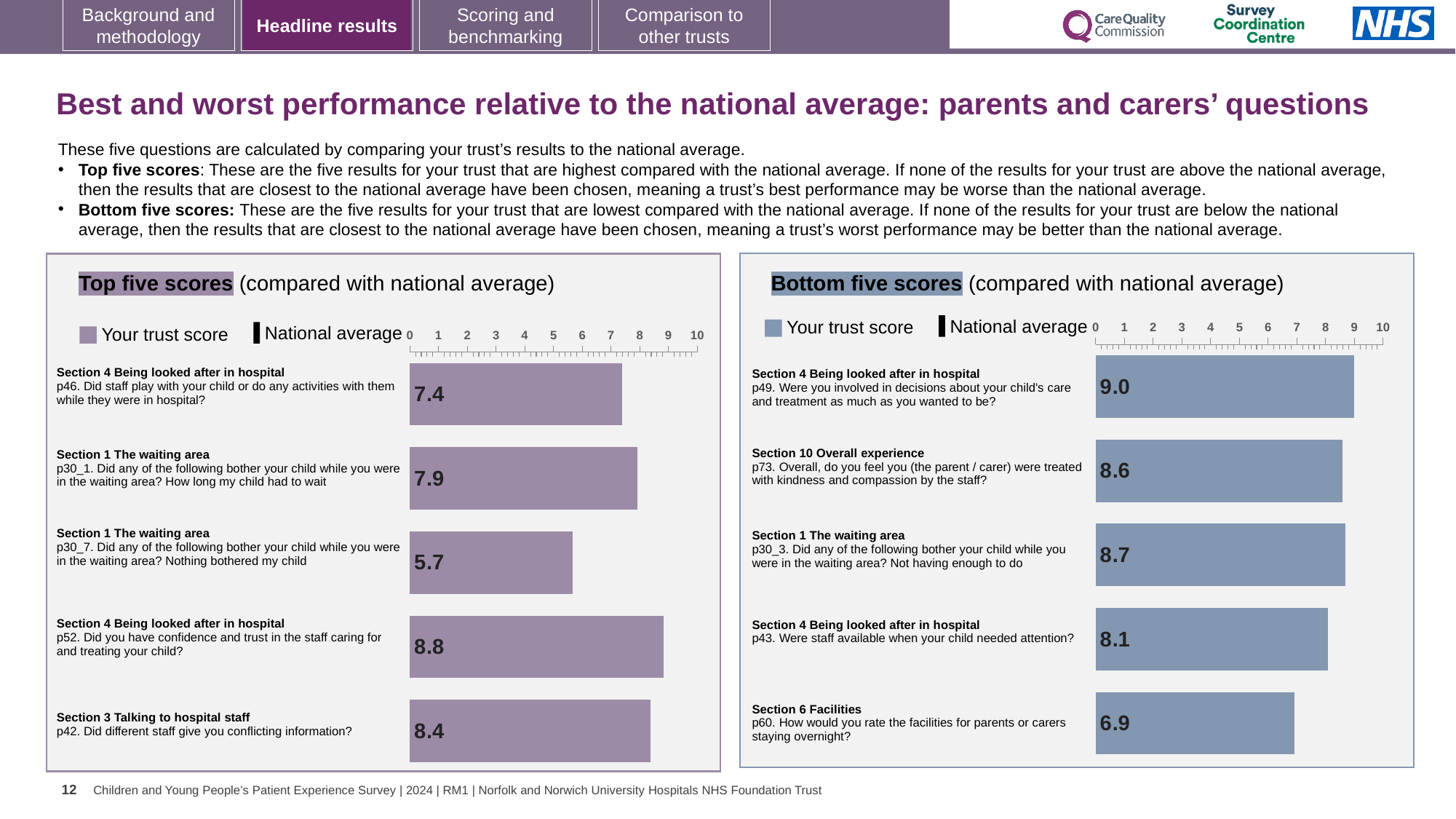
In the Top five scores chart, which question has the highest trust score? p52. Did you have confidence and trust in the staff caring for and treating your child? In the Bottom five scores chart, which has the larger trust score: p73 (treated with kindness and compassion) or p43 (staff available when your child needed attention)? p73 In the Top five scores chart, what is the trust score for p30_7 (Nothing bothered my child in the waiting area)? 5.7 In the Bottom five scores chart, what is the difference between the trust scores for p49 and p60? 2.1 In the Top five scores chart, which question has the lowest trust score? p30_7. Did any of the following bother your child while you were in the waiting area? Nothing bothered my child In the Top five scores chart, what is the trust score for p52 (Did you have confidence and trust in the staff caring for and treating your child)? 8.8 In the Bottom five scores chart, what is the trust score for p60 (How would you rate the facilities for parents or carers staying overnight)? 6.9 How many questions are shown in the Bottom five scores chart? 5 In the Bottom five scores chart, what is the trust score for p49 (Were you involved in decisions about your child's care and treatment as much as you wanted to be)? 9.0 In the Bottom five scores chart, which question has the lowest trust score? p60. How would you rate the facilities for parents or carers staying overnight? In the Top five scores chart, what is the difference between the trust scores for p52 and p46? 1.4 What type of chart is the Top five scores chart? Bar chart